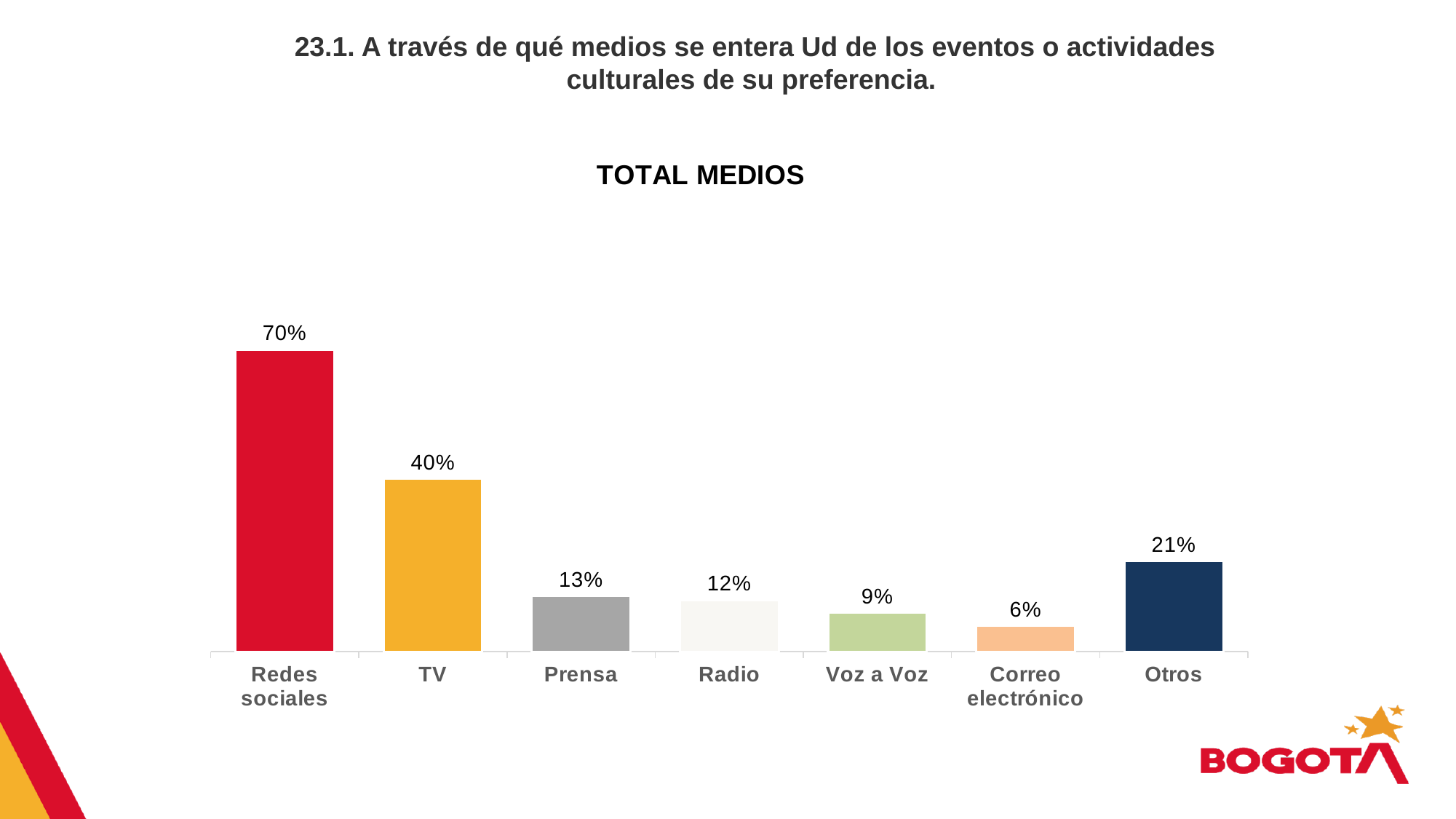
What is the value for Correo electrónico? 6% What kind of chart is shown on the slide? Bar chart Which category has the lowest value? Correo electrónico What is the value for Redes sociales? 70% What is the value for TV? 40% Which is larger, the value for Prensa or the value for Voz a Voz? Prensa How many categories are shown in the chart? 7 What is the value for Otros? 21% Which category has the highest value? Redes sociales What is the difference between the values for Otros and Radio? 9% What is the difference between the values for Redes sociales and TV? 30% What is the title shown directly above the chart? TOTAL MEDIOS